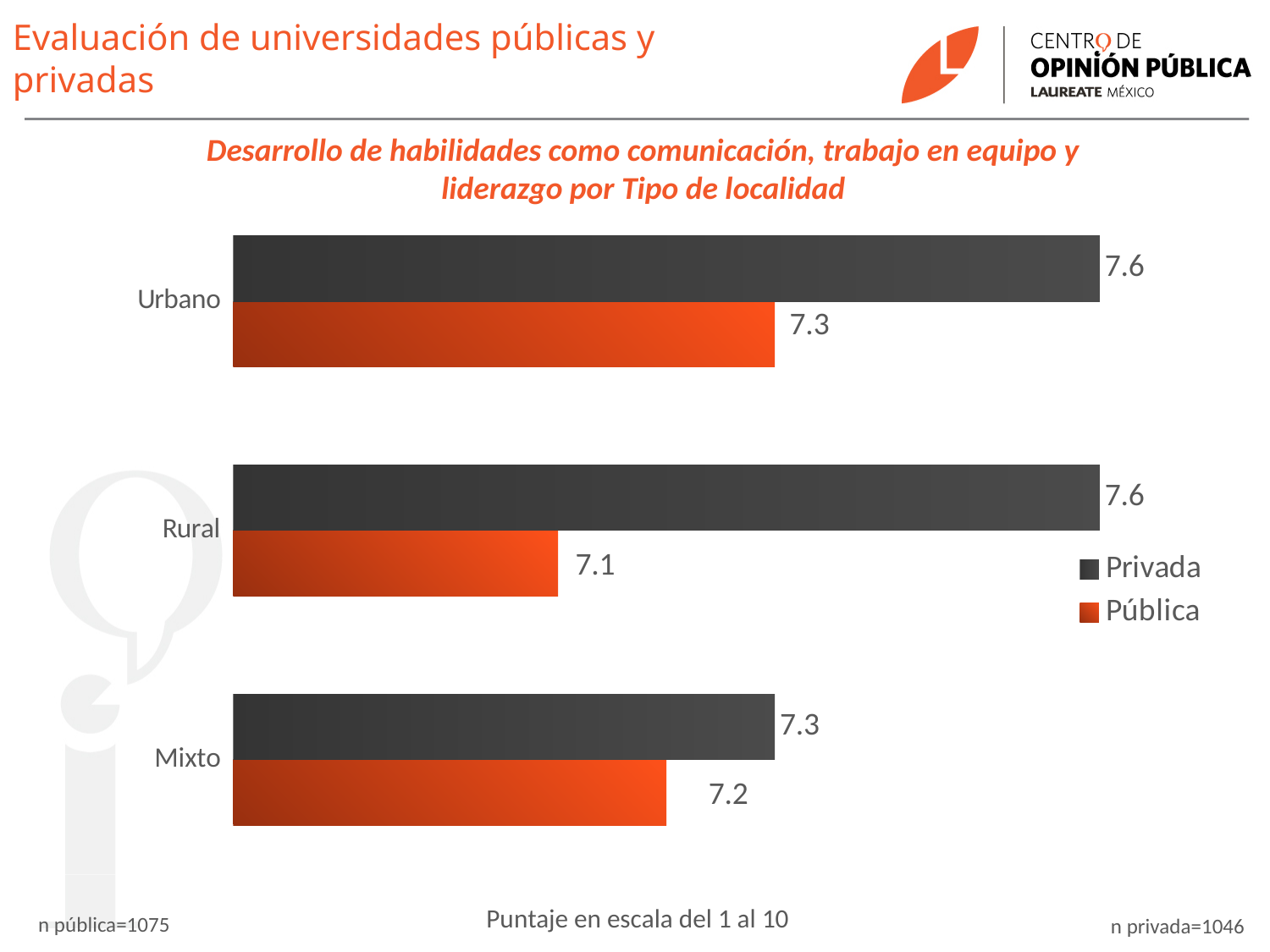
What is the value for Pública in the Rural category? 7.1 What is the difference between the Privada and Pública values in the Rural category? 0.5 How many categories are shown on the chart? 3 What is the difference between the Privada and Pública values in the Urbano category? 0.3 What is the value for Pública in the Mixto category? 7.2 How many series does the legend list? 2 What kind of chart is shown on the slide? Bar chart Which is larger in the Mixto category, Privada or Pública? Privada What is the value for Privada in the Mixto category? 7.3 Which category has the lowest value for Pública? Rural Which category has the lowest value for Privada? Mixto What is the value for Privada in the Urbano category? 7.6